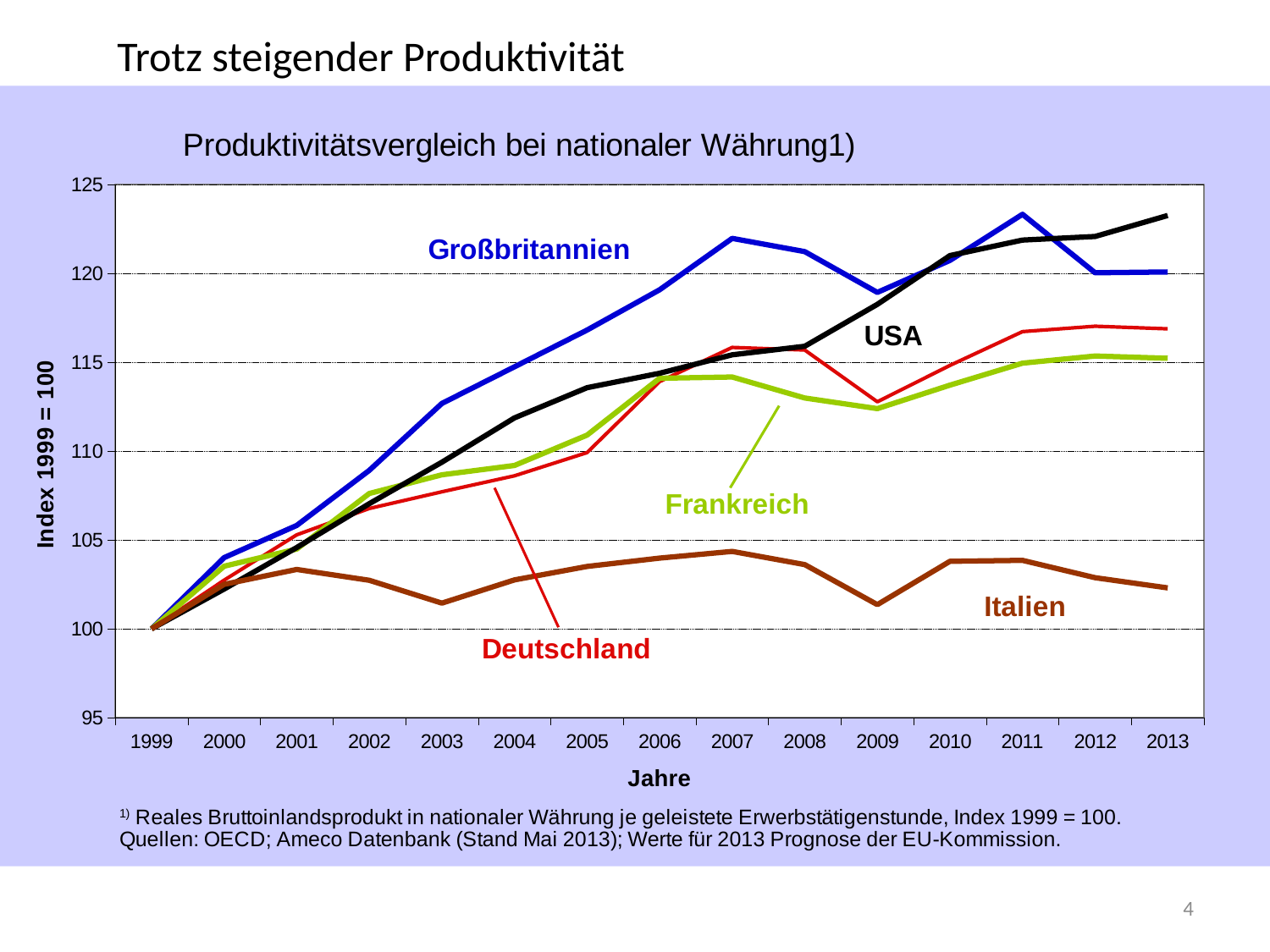
Is the value for Italien in 2013 greater or less than 105? less Is the value for Großbritannien in 2007 greater or less than 120? greater Is the value for Frankreich in 2009 greater or less than 110? greater In 2013, which is higher: Deutschland or Frankreich? Deutschland Which country has the lowest index value in 2013? Italien What kind of chart is shown on the slide? line chart How many countries (lines) are shown in the chart? 5 What is the index value for Deutschland in 1999? 100 Which country has the highest index value in 2007? Großbritannien Which country has the highest index value in 2013? USA How many years are plotted along the x axis of the chart? 15 What is the label of the y axis? Index 1999 = 100